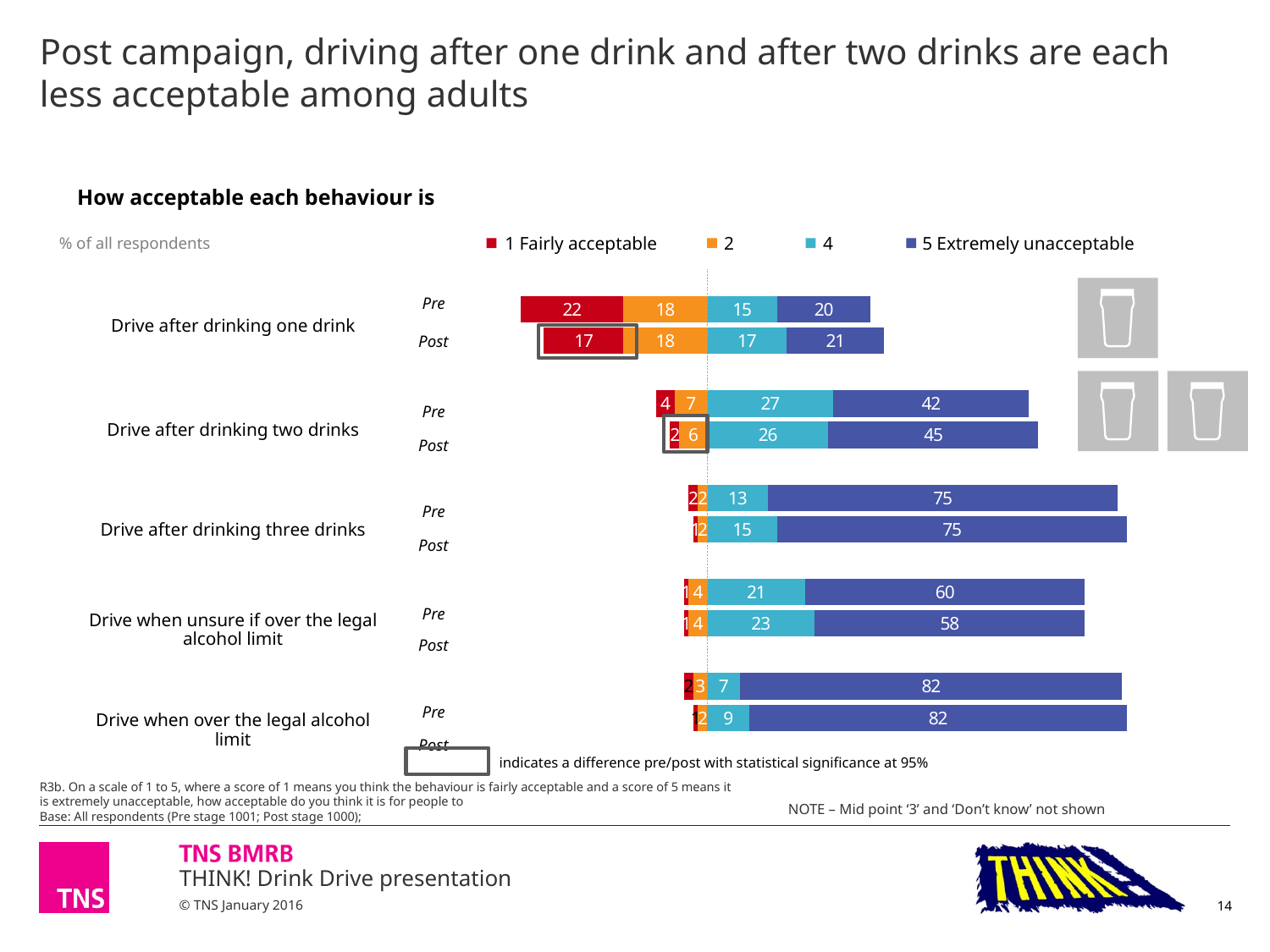
What is the total of the Post stacked bar for 'Drive after drinking one drink'? 73 What is the '1 Fairly acceptable' value for 'Drive after drinking one drink' at the Pre stage? 22 What is the '1 Fairly acceptable' value for 'Drive after drinking one drink' at the Post stage? 17 What is the '5 Extremely unacceptable' value for 'Drive when over the legal alcohol limit' at the Pre stage? 82 What is the difference between the Pre and Post '5 Extremely unacceptable' values for 'Drive after drinking two drinks'? 3 What is the '5 Extremely unacceptable' value for 'Drive after drinking two drinks' at the Post stage? 45 By how much did the '1 Fairly acceptable' value for 'Drive after drinking one drink' fall from Pre to Post? 5 What is the '4' value for 'Drive when unsure if over the legal alcohol limit' at the Post stage? 23 How many series does the legend list? 4 Is the '5 Extremely unacceptable' value larger for 'Drive after drinking three drinks' Post or 'Drive when unsure if over the legal alcohol limit' Post? Drive after drinking three drinks What type of chart is shown on the slide? Stacked bar chart Which behaviour has the highest '5 Extremely unacceptable' value at the Post stage? Drive when over the legal alcohol limit